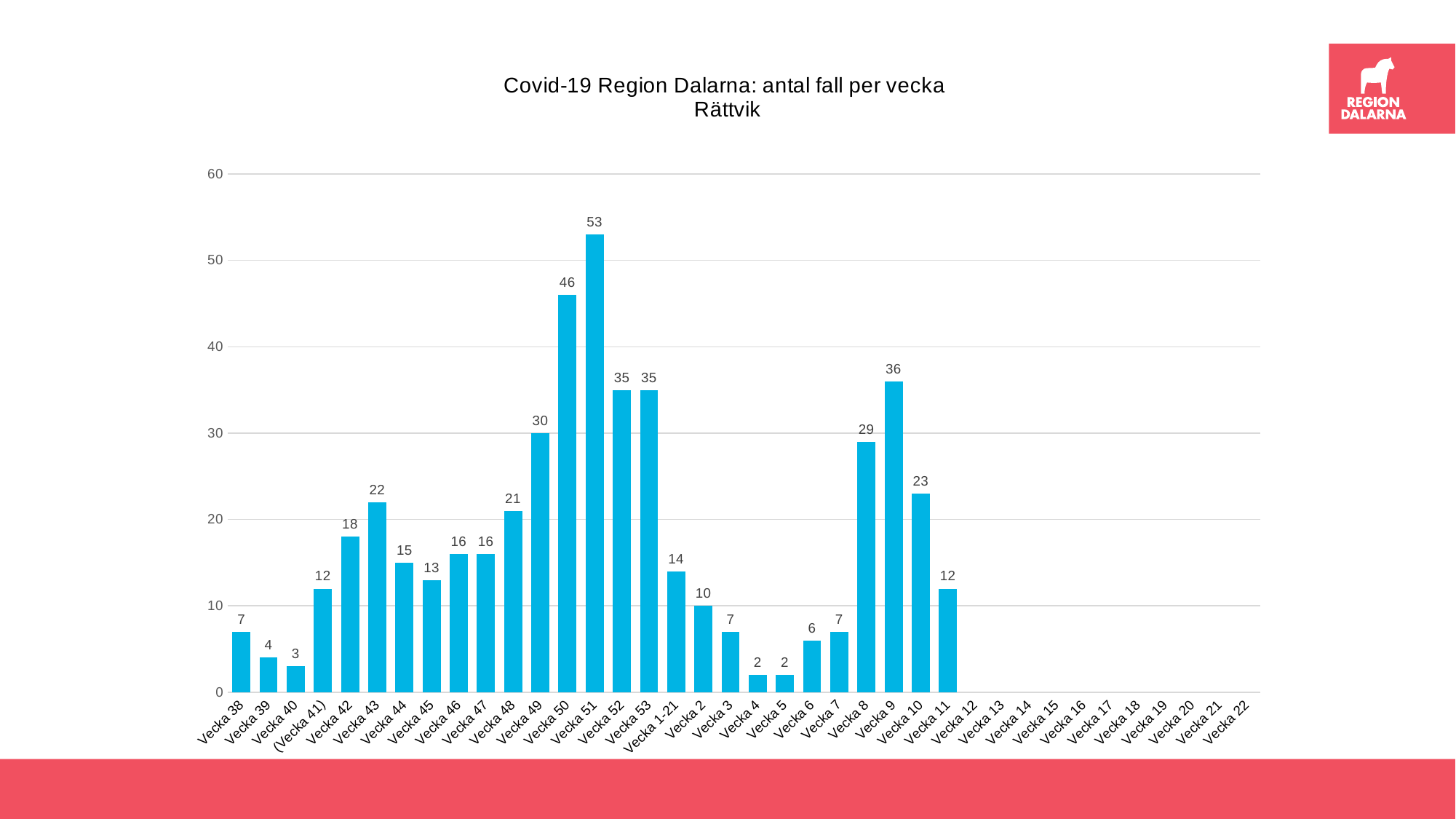
What is the title of the chart? Covid-19 Region Dalarna: antal fall per vecka Rättvik What kind of chart is shown on the slide? bar chart What is the value for Vecka 51? 53 What is the difference between the values for Vecka 9 and Vecka 8? 7 Which week has the highest number of cases? Vecka 51 What is the value for Vecka 43? 22 Is the value for Vecka 50 greater or less than 40? greater What is the value for Vecka 1-21? 14 What is the difference between the values for Vecka 51 and Vecka 50? 7 What is the value for Vecka 9? 36 Which is larger, the value for Vecka 42 or the value for Vecka 11? Vecka 42 Which is larger, the value for Vecka 49 or the value for Vecka 10? Vecka 49